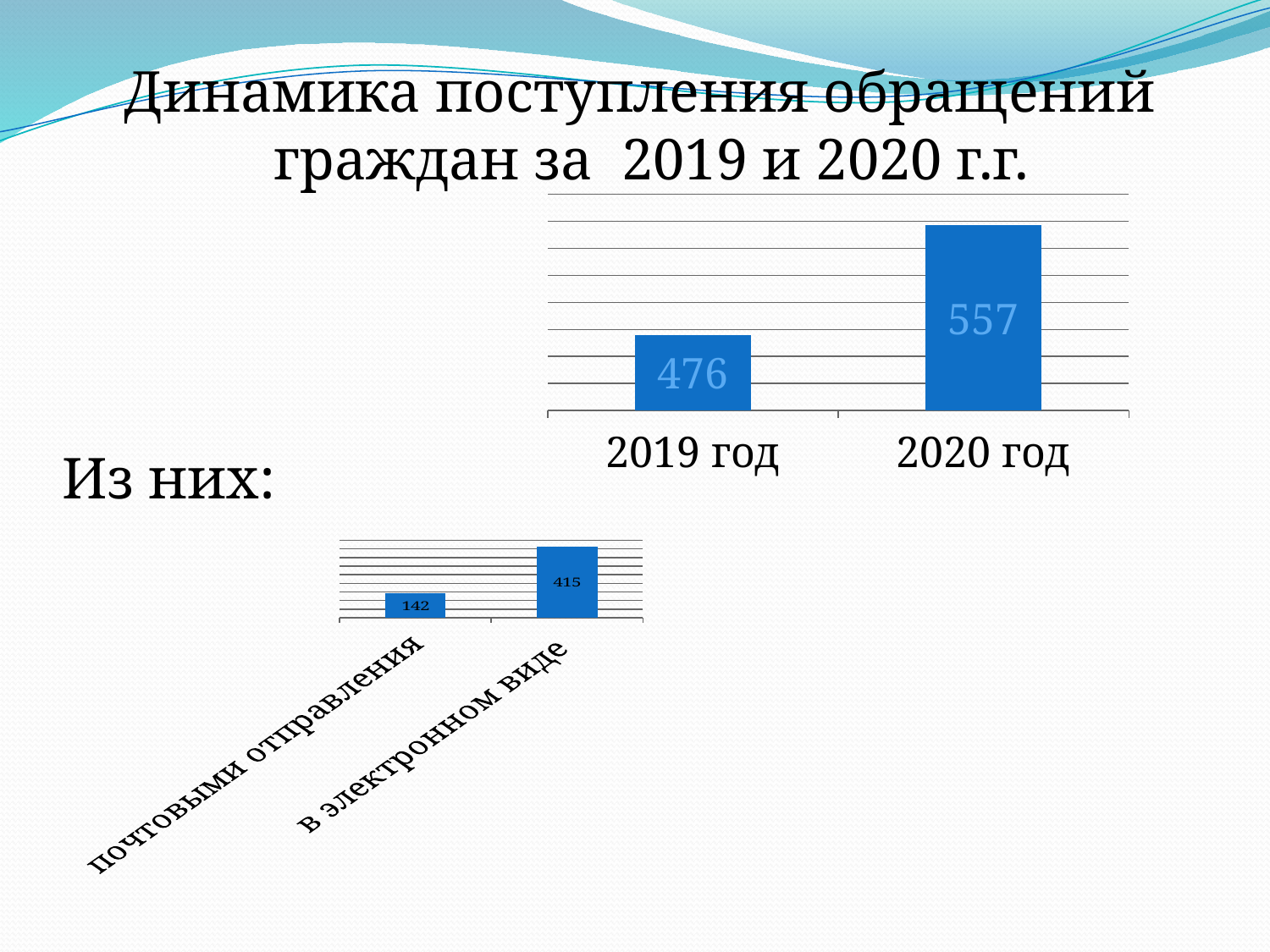
In the top-right chart, what is the value for 2019 год? 476 In the top-right chart, what is the difference between the values for 2020 год and 2019 год? 81 In the top-right chart, which year has the higher value? 2020 год How many charts are on the slide? 2 In the top-right chart, what is the value for 2020 год? 557 In the bottom-left chart, what is the value for почтовыми отправлениями? 142 In the top-right chart, do the values rise or fall from 2019 год to 2020 год? rise In the top-right chart, how many categories are shown? 2 In the bottom-left chart, what is the value for в электронном виде? 415 In the bottom-left chart, which category has the lowest value? почтовыми отправления What type of chart is the top-right chart? bar chart In the bottom-left chart, what is the difference between the values for в электронном виде and почтовыми отправлениями? 273